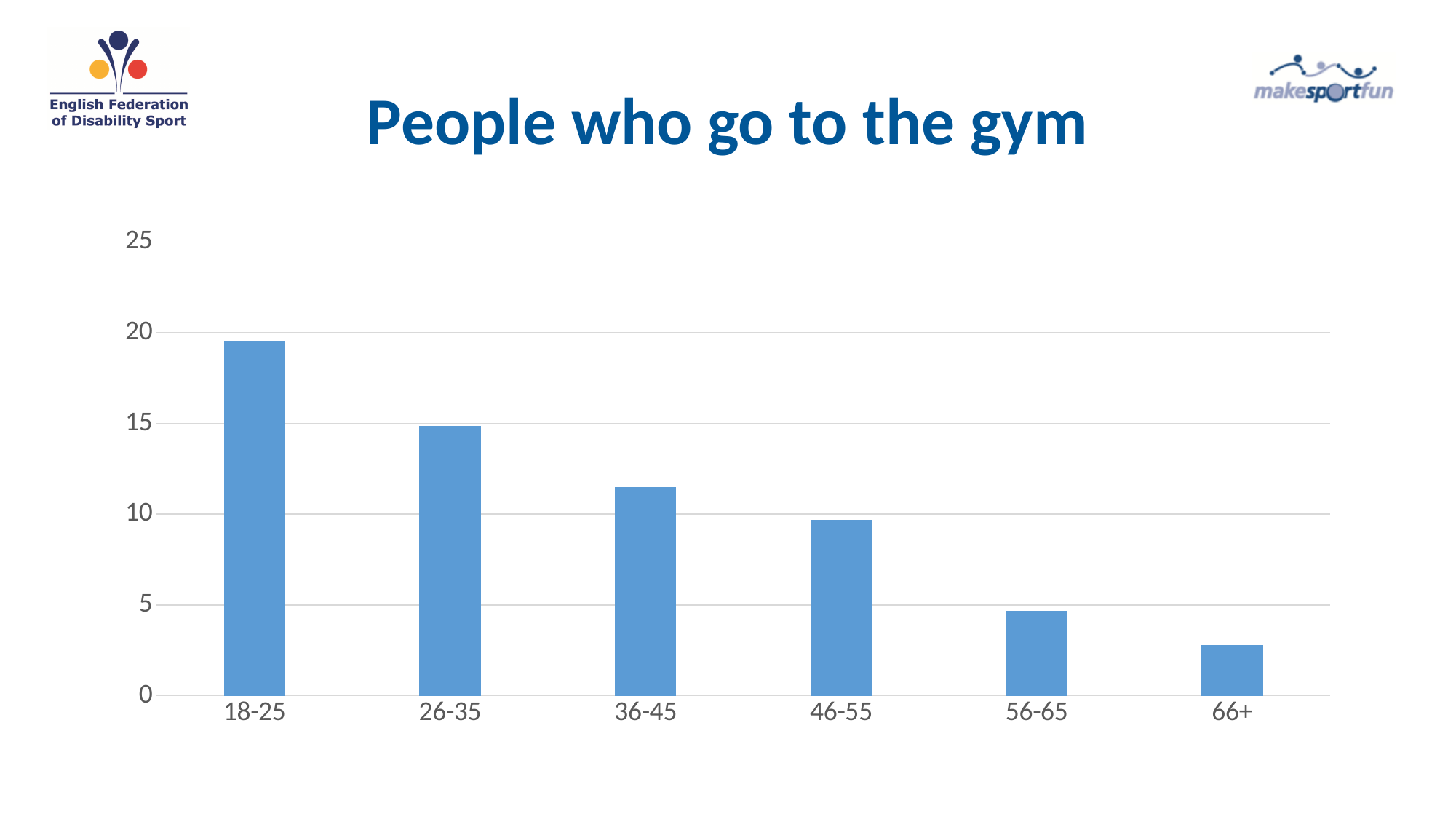
Which is larger, the value for 18-25 or the value for 26-35? 18-25 Is the value for 18-25 greater or less than 15? greater What kind of chart is shown on the slide? Bar chart Is the value for 66+ greater or less than 5? less Which is larger, the value for 36-45 or the value for 56-65? 36-45 Which age group has the highest value? 18-25 Which age group has the lowest value? 66+ How many age categories are shown on the x axis? 6 What is the title of the chart? People who go to the gym Is the value for 26-35 greater or less than 10? greater Do the values rise or fall as you move from 18-25 to 66+ along the x axis? Fall